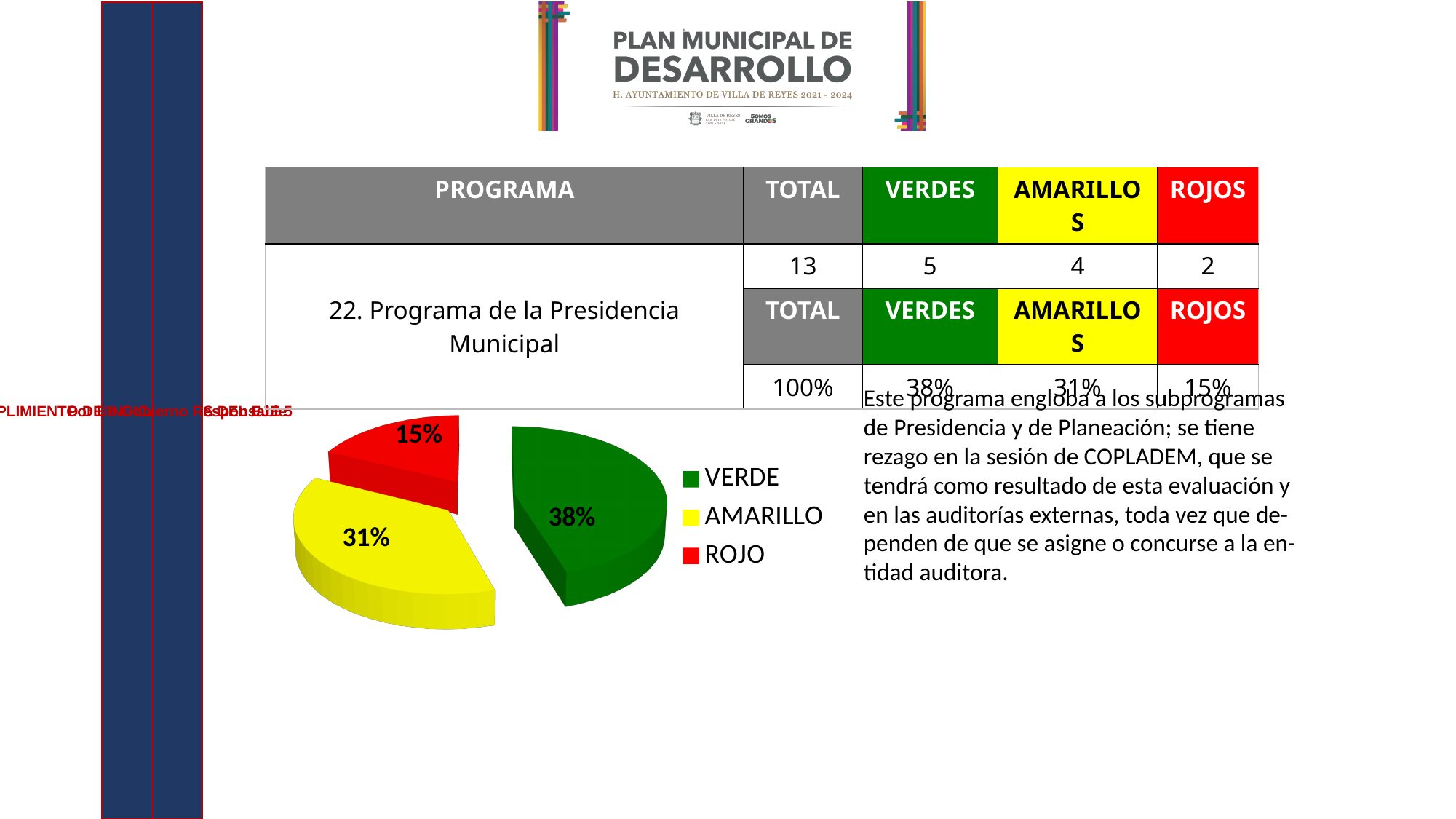
What is the difference in percentage points between the VERDE and AMARILLO slices? 7 Which slice of the pie chart is the smallest? ROJO How many slices does the pie chart have? 3 Which slice of the pie chart is the largest? VERDE How many entries does the pie chart's legend list? 3 What percentage is shown for the ROJO slice of the pie chart? 15% What kind of chart is shown on the slide? Pie chart What percentage is shown for the AMARILLO slice of the pie chart? 31% What is the difference in percentage points between the AMARILLO and ROJO slices? 16 What percentage is shown for the VERDE slice of the pie chart? 38% What colour is the ROJO slice in the pie chart? Red Which is larger in the pie chart, AMARILLO or ROJO? AMARILLO